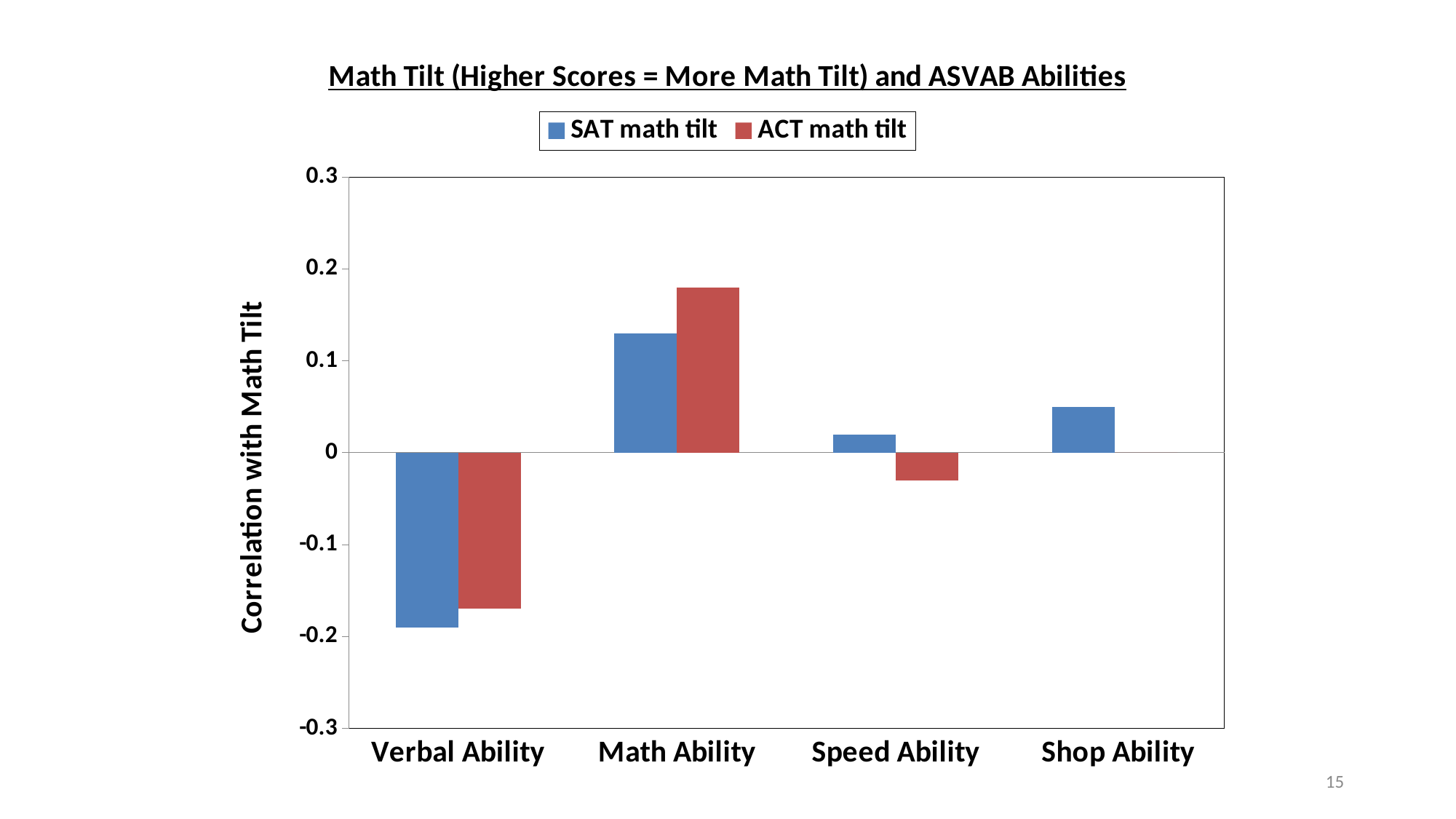
For Math Ability, which is larger: the SAT math tilt or the ACT math tilt correlation? ACT math tilt Is the SAT math tilt value for Verbal Ability greater or less than -0.1? less How many series does the legend list? 2 Which category has the lowest ACT math tilt correlation? Verbal Ability Is the ACT math tilt value for Math Ability greater or less than 0.1? greater Which category has the highest SAT math tilt correlation? Math Ability What is the title of the y axis? Correlation with Math Tilt How many ability categories are shown on the x axis? 4 What kind of chart is shown on the slide? bar chart For Speed Ability, which is larger: the SAT math tilt or the ACT math tilt correlation? SAT math tilt Which category has the highest ACT math tilt correlation? Math Ability Which category has the lowest SAT math tilt correlation? Verbal Ability